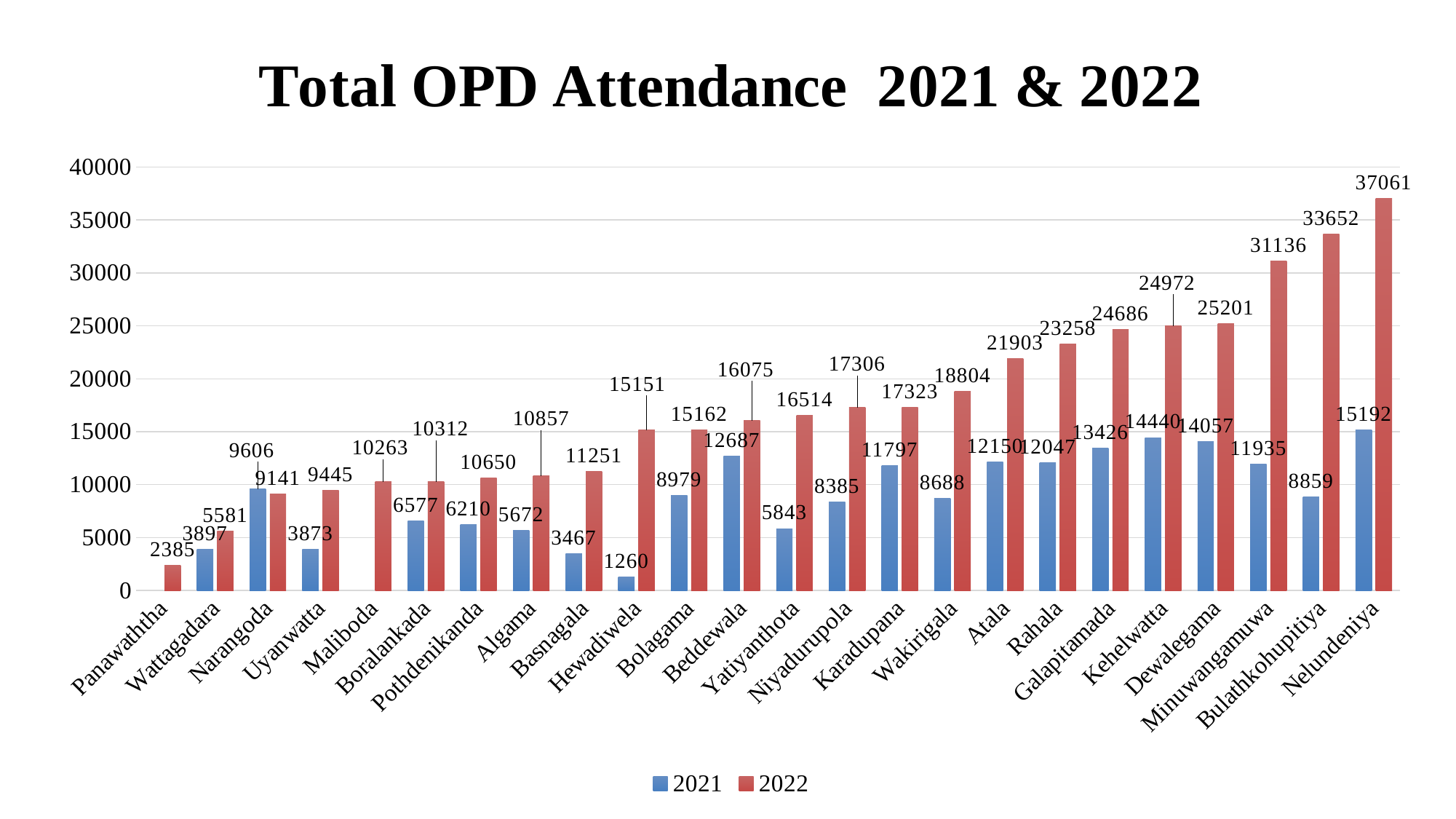
How many series does the legend list? 2 What was the total OPD attendance for Nelundeniya in 2022? 37061 For Narangoda, was OPD attendance higher in 2021 or 2022? 2021 How many locations are shown on the x axis of the chart? 24 What is the difference between the 2022 and 2021 OPD attendance for Nelundeniya? 21869 What kind of chart is shown on the slide? Bar chart Which location had the highest OPD attendance in 2022? Nelundeniya Is the 2022 OPD attendance for Minuwangamuwa greater or less than 30000? greater What was the total OPD attendance for Hewadiwela in 2021? 1260 What was the 2022 OPD attendance for Karadupana? 17323 Which location had the lowest OPD attendance in 2022? Panawaththa Which location had the lowest OPD attendance in 2021? Hewadiwela